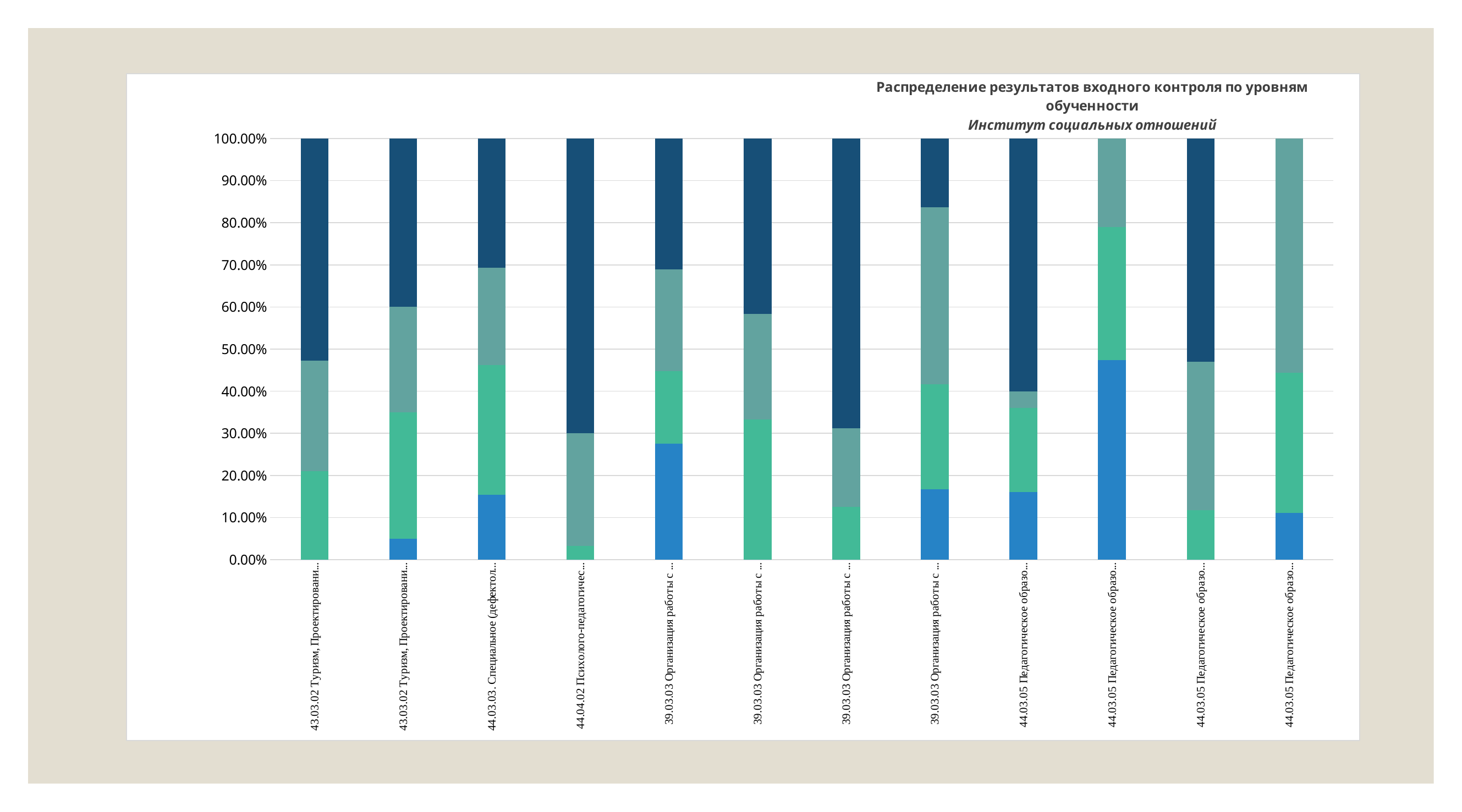
How many bars (categories) are plotted in the chart? 12 In the first bar from the left, is the top of the bottom green segment greater or less than 30%? less In the twelfth bar from the left, is the top of the green segment greater or less than 40%? greater In the tenth bar from the left, is the bottom blue segment greater or less than 40%? greater How many bars have no dark navy top segment? 2 Which institute is named in the italic subtitle of the chart? Институт социальных отношений Which bar has a larger bottom blue segment: the second bar from the left or the fifth bar from the left? The fifth bar from the left What kind of chart is shown on the slide? Stacked bar chart Which bar has the largest bottom blue segment? The tenth bar from the left What is the title of the chart? Распределение результатов входного контроля по уровням обученности